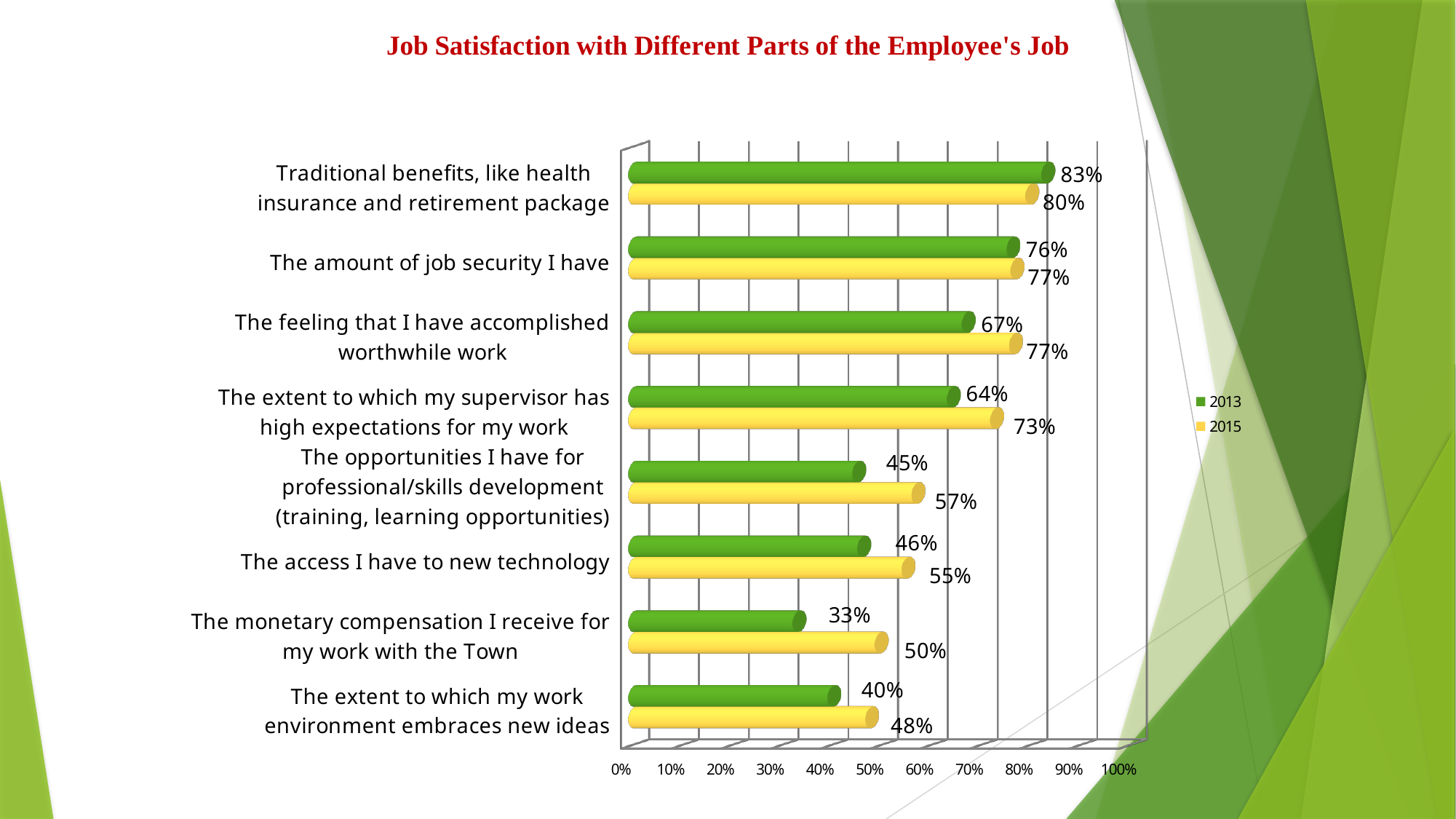
Which category has the highest 2013 value? Traditional benefits, like health insurance and retirement package What is the difference between the 2015 and 2013 values for "The monetary compensation I receive for my work with the Town"? 17% How many series does the legend list? 2 What is the 2015 value for "The monetary compensation I receive for my work with the Town"? 50% What kind of chart is shown on the slide? Bar chart What is the 2013 value for "Traditional benefits, like health insurance and retirement package"? 83% Which category has the lowest 2013 value? The monetary compensation I receive for my work with the Town For "The extent to which my supervisor has high expectations for my work", which year has the larger value, 2013 or 2015? 2015 What is the title of the chart? Job Satisfaction with Different Parts of the Employee's Job What is the 2015 value for "The feeling that I have accomplished worthwhile work"? 77% Which category has the lowest 2015 value? The extent to which my work environment embraces new ideas How many categories are shown on the chart? 8